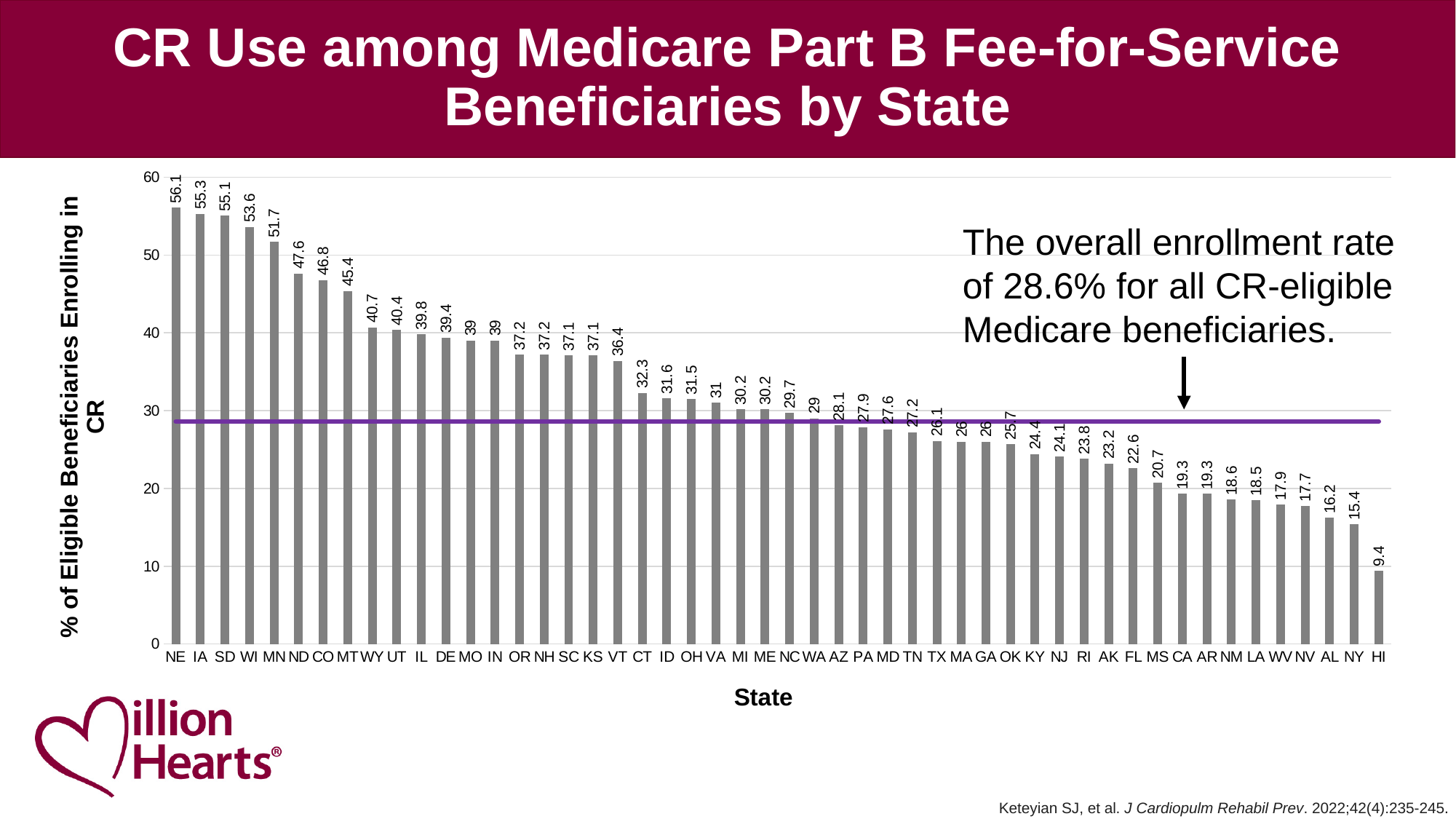
Is the value for WY greater or less than 40? greater Which state has the highest value? NE How many states are shown on the x axis? 50 What is the value for HI? 9.4 Which has a larger value, MN or ND? MN What is the value for FL? 22.6 What kind of chart is this? bar chart What is the value for NE? 56.1 Which state has the lowest value? HI What is the difference between the values for NE and HI? 46.7 What is the value for CT? 32.3 What overall enrollment rate does the horizontal purple line represent? 28.6%